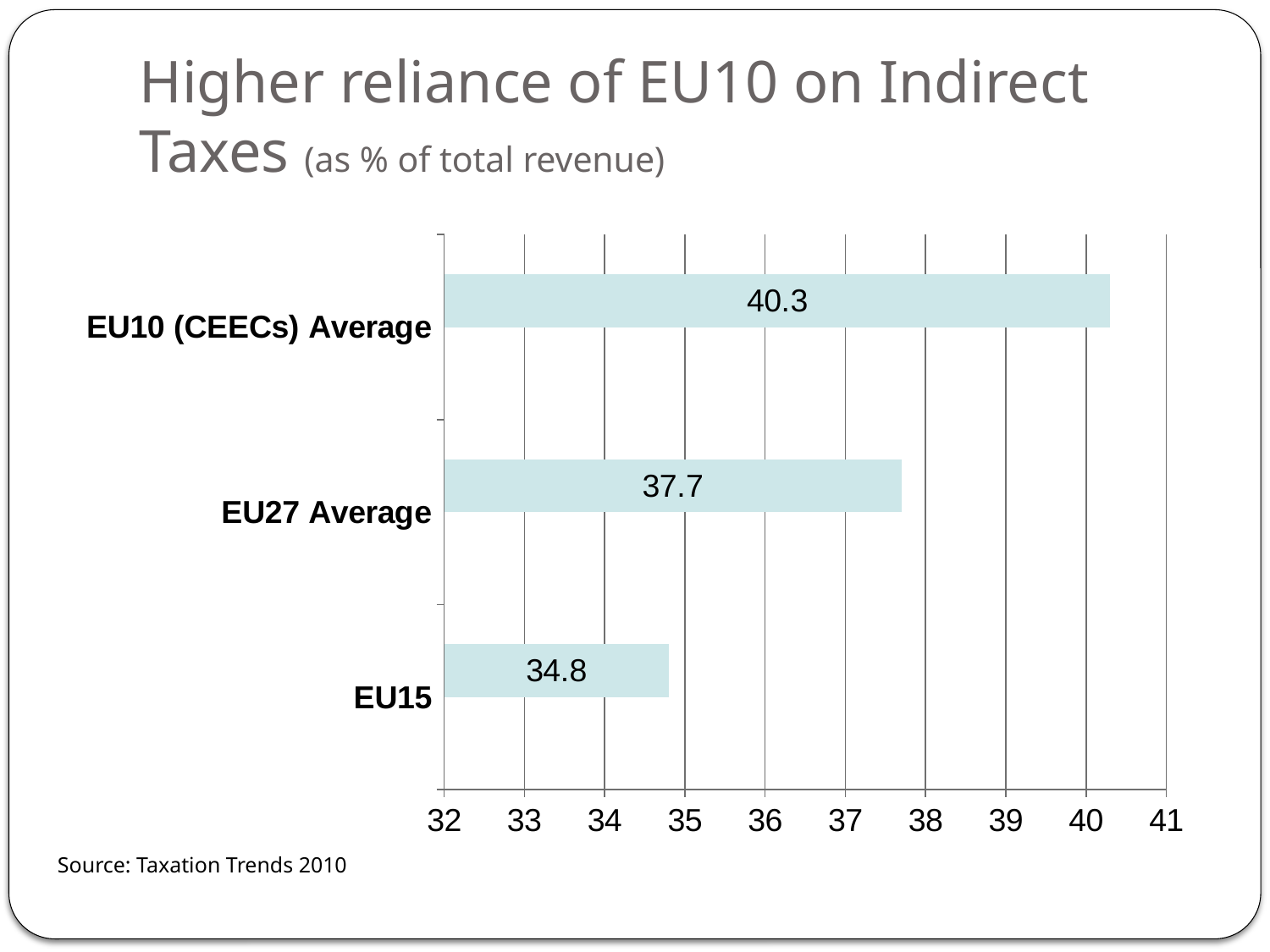
Which category has the highest value? EU10 (CEECs) Average What is the value for EU15? 34.8 Which is larger, the value for EU27 Average or the value for EU15? EU27 Average How many categories are shown in the chart? 3 What kind of chart is shown on the slide? Bar chart Which category has the lowest value? EU15 Is the value for EU27 Average greater or less than 37? greater What is the value for EU10 (CEECs) Average? 40.3 What source is cited for the chart data? Taxation Trends 2010 What is the difference between the EU10 (CEECs) Average and the EU15 values? 5.5 What is the value for EU27 Average? 37.7 What is the difference between the EU10 (CEECs) Average and the EU27 Average values? 2.6